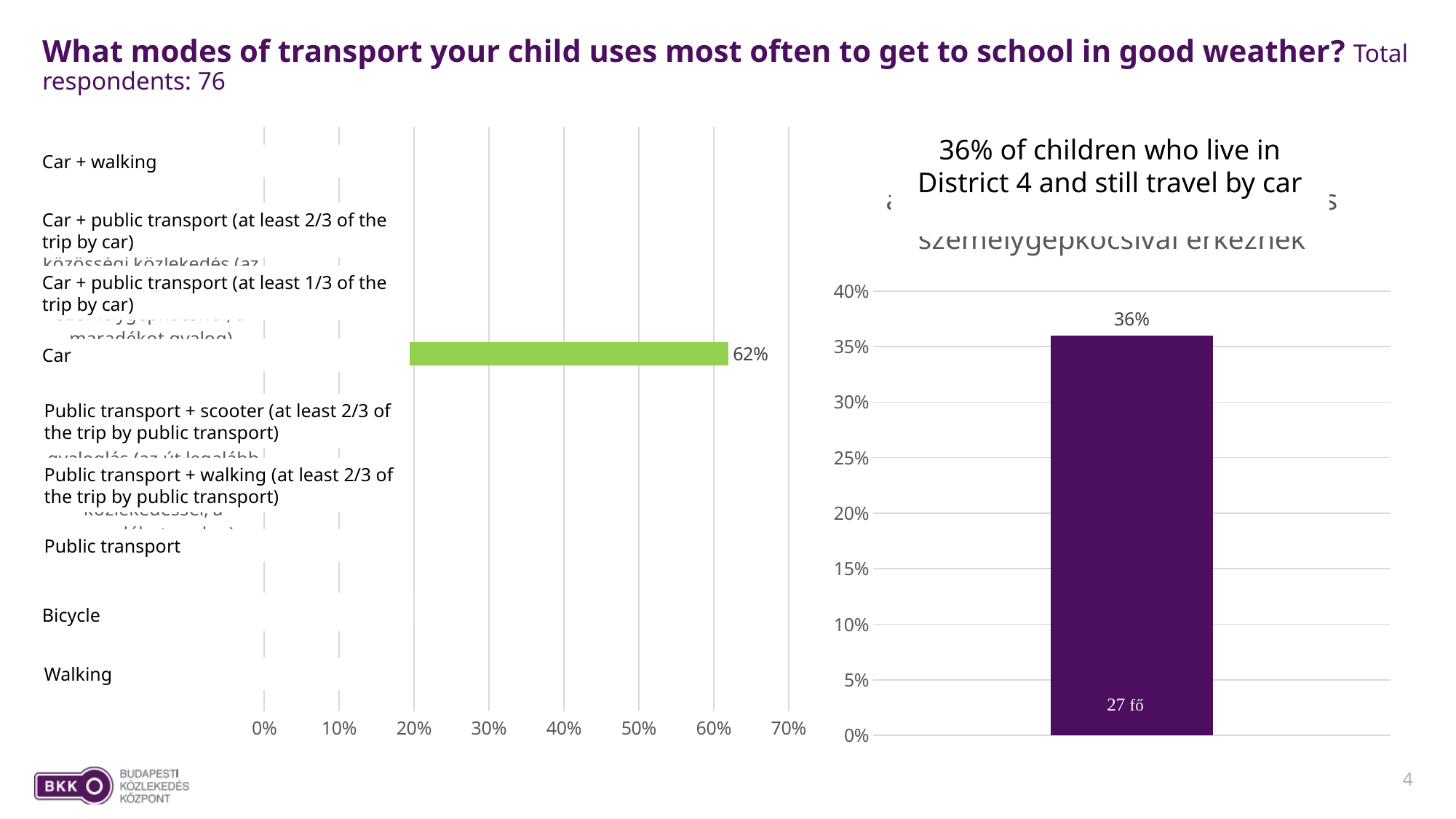
In the left chart, is the value for 'Car' greater or less than 50%? greater In the left chart, is the value for 'Car' greater or less than 70%? less How many transport mode categories are listed on the left chart's axis? 9 What is the highest value shown on the right chart's vertical axis? 40% In the left chart, what percentage is shown for the 'Car' category? 62% What is the total number of respondents stated in the slide title? 76 What kind of chart is the left chart? Bar chart In the right chart, what percentage of children who live in District 4 still travel by car? 36% In the right chart, is the bar's value greater or less than 30%? greater What kind of chart is the right chart? Bar chart In the right chart, what count label is printed inside the bar? 27 fő